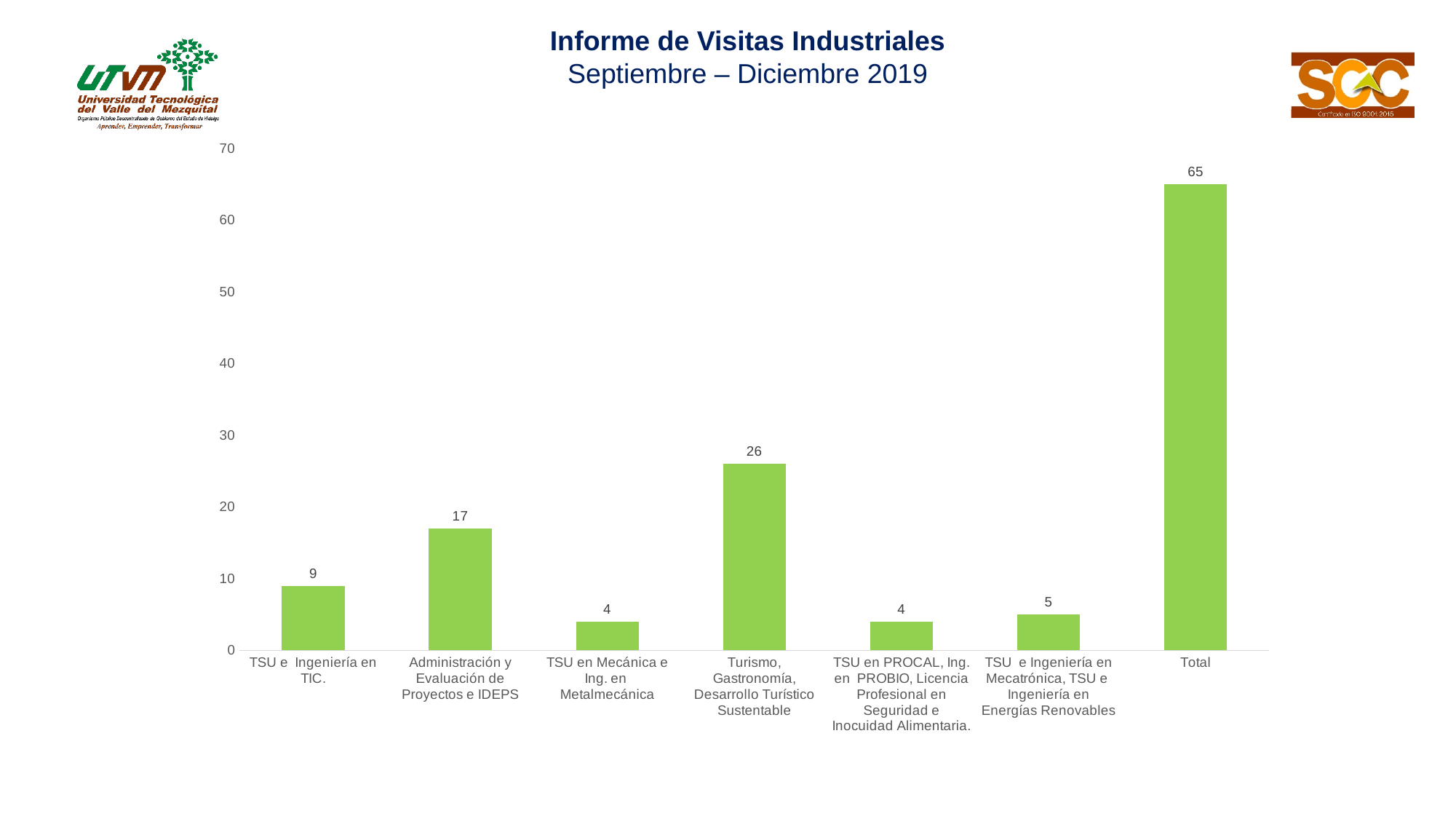
What kind of chart is shown on the slide? bar chart Which is larger: the value for TSU e Ingeniería en TIC. or the value for TSU e Ingeniería en Mecatrónica, TSU e Ingeniería en Energías Renovables? TSU e Ingeniería en TIC. Excluding the Total bar, which category has the highest value? Turismo, Gastronomía, Desarrollo Turístico Sustentable What is the value for TSU en Mecánica e Ing. en Metalmecánica? 4 What is the difference between the values for Turismo, Gastronomía, Desarrollo Turístico Sustentable and Administración y Evaluación de Proyectos e IDEPS? 9 What is the title of the slide? Informe de Visitas Industriales Septiembre – Diciembre 2019 What is the value for Administración y Evaluación de Proyectos e IDEPS? 17 What is the value for Total? 65 How many bars are shown in the chart? 7 Is the value for Total greater or less than 60? greater What is the value for TSU e Ingeniería en TIC.? 9 What is the value for Turismo, Gastronomía, Desarrollo Turístico Sustentable? 26